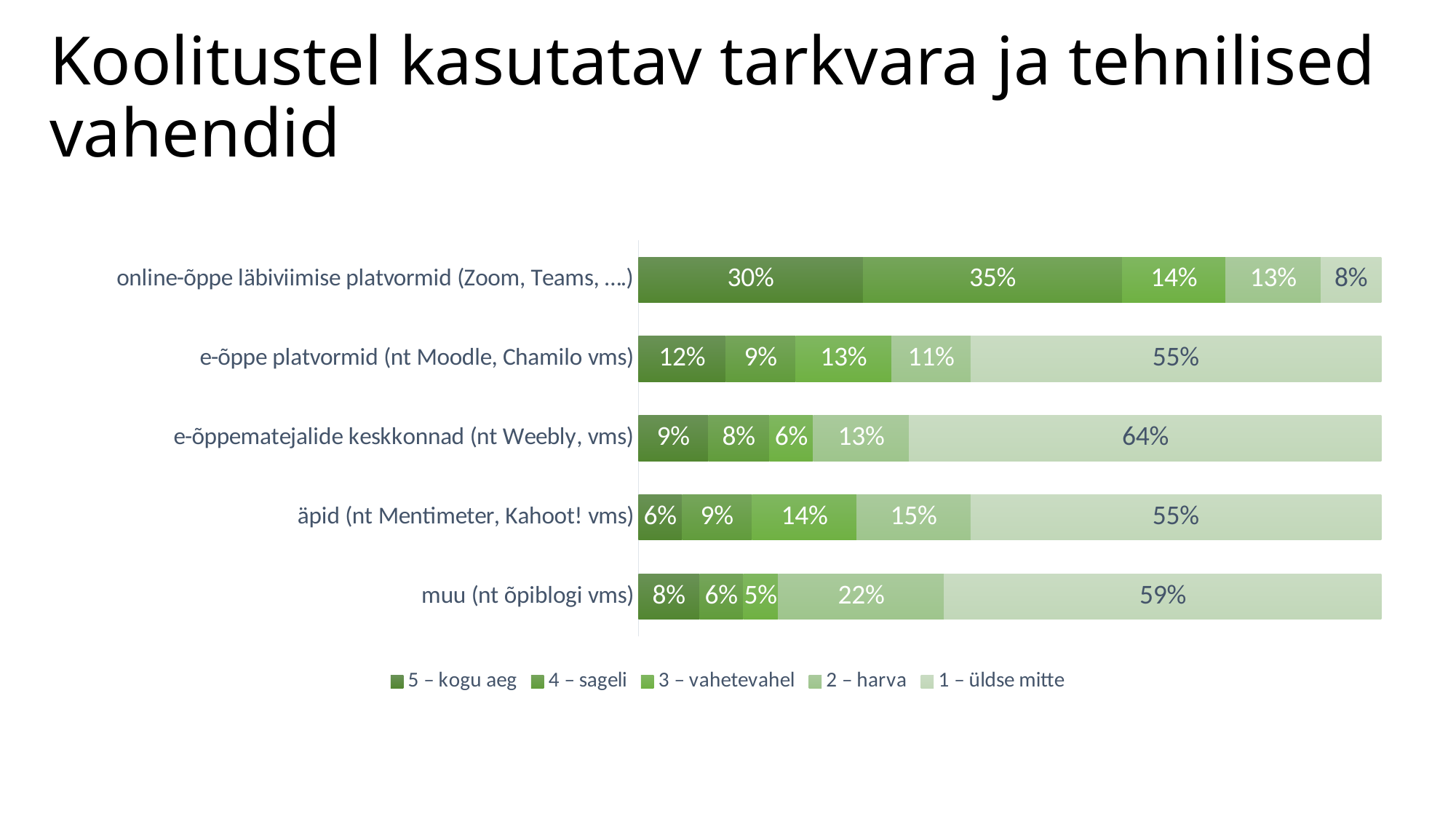
Which category has the lowest "5 – kogu aeg" value? äpid (nt Mentimeter, Kahoot! vms) What is the "3 – vahetevahel" value for äpid (nt Mentimeter, Kahoot! vms)? 14% What percentage of respondents chose "5 – kogu aeg" for online-õppe läbiviimise platvormid (Zoom, Teams, ….)? 30% Which category has the highest "1 – üldse mitte" value? e-õppematejalide keskkonnad (nt Weebly, vms) What is the "2 – harva" value for muu (nt õpiblogi vms)? 22% What is the "1 – üldse mitte" value for e-õppematejalide keskkonnad (nt Weebly, vms)? 64% What kind of chart is shown on the slide? Stacked bar chart What is the title of the slide? Koolitustel kasutatav tarkvara ja tehnilised vahendid Which is larger: the "2 – harva" value for äpid (nt Mentimeter, Kahoot! vms) or for e-õppe platvormid (nt Moodle, Chamilo vms)? äpid (nt Mentimeter, Kahoot! vms) How many series does the legend list? 5 How many categories are shown on the chart? 5 What is the difference between the "4 – sageli" value for online-õppe läbiviimise platvormid (Zoom, Teams, ….) and for e-õppe platvormid (nt Moodle, Chamilo vms)? 26%